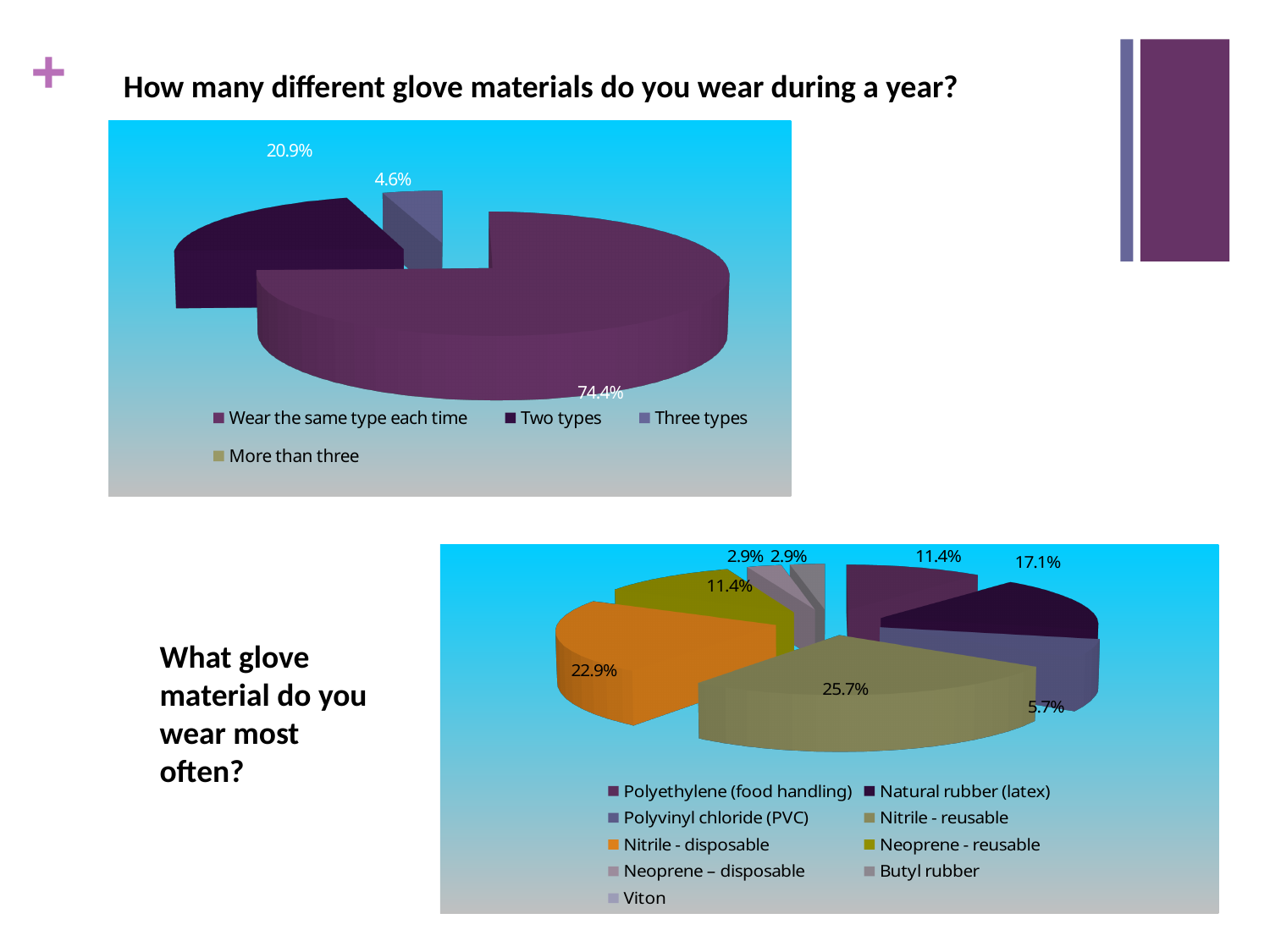
In the chart for "What glove material do you wear most often?", what percentage is shown for "Natural rubber (latex)"? 17.1% In the chart for "What glove material do you wear most often?", which is larger, the share for "Natural rubber (latex)" or the share for "Polyvinyl chloride (PVC)"? Natural rubber (latex) In the chart titled "How many different glove materials do you wear during a year?", which category has the largest share? Wear the same type each time How many entries does the legend list in the chart titled "How many different glove materials do you wear during a year?"? 4 In the chart for "What glove material do you wear most often?", what percentage is shown for "Nitrile - disposable"? 22.9% In the chart titled "How many different glove materials do you wear during a year?", what is the difference between the shares for "Two types" and "Three types"? 16.3% How many entries does the legend list in the chart for "What glove material do you wear most often?"? 9 In the chart titled "How many different glove materials do you wear during a year?", what percentage is shown for "Wear the same type each time"? 74.4% In the chart titled "How many different glove materials do you wear during a year?", what percentage is shown for "Three types"? 4.6% In the chart titled "How many different glove materials do you wear during a year?", what percentage is shown for "Two types"? 20.9% What kind of chart is used for "What glove material do you wear most often?"? Pie chart In the chart for "What glove material do you wear most often?", what percentage is shown for "Nitrile - reusable"? 25.7%